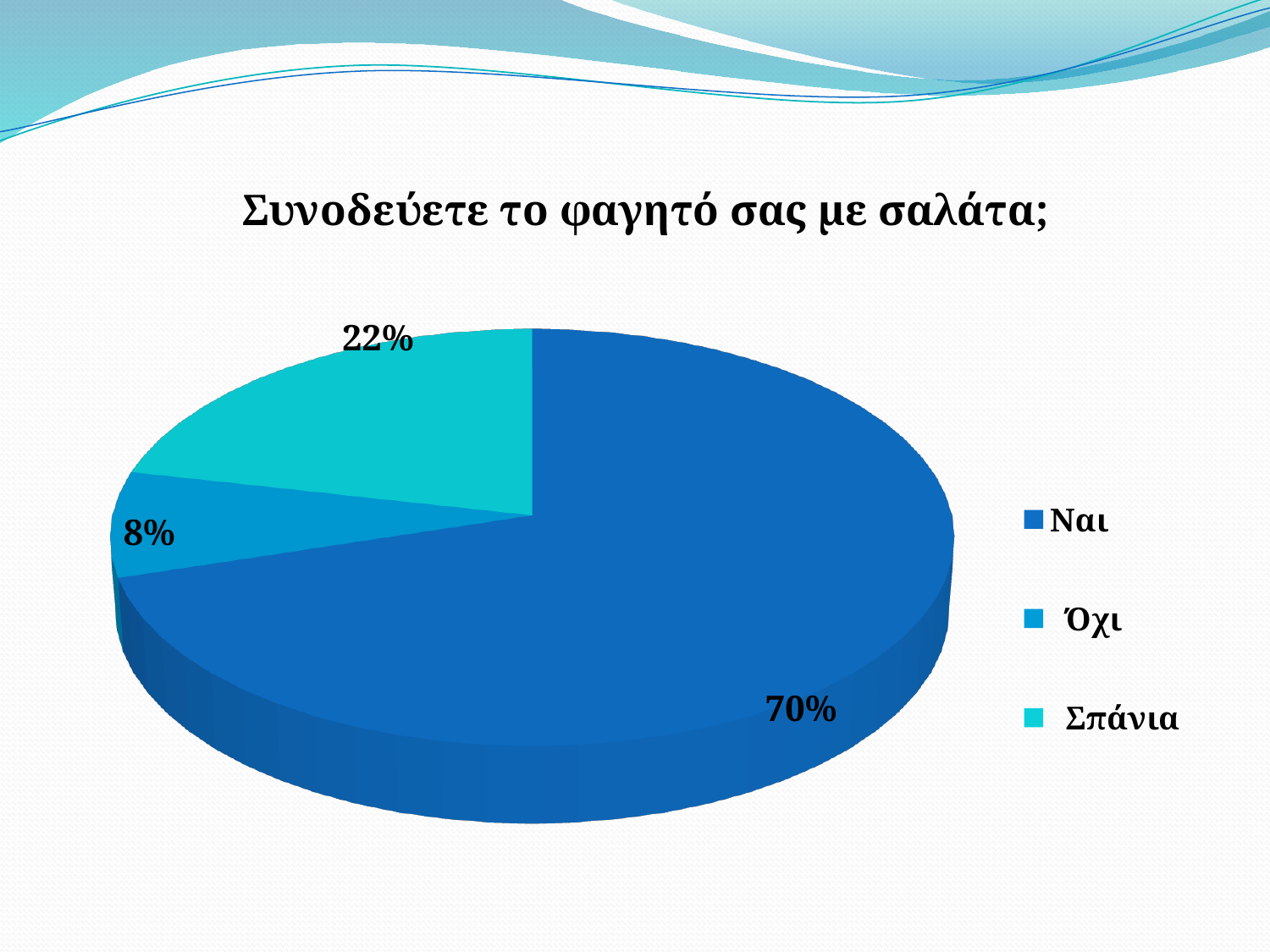
Which answer has the smallest share of the pie? Όχι What kind of chart is shown on the slide? Pie chart Which answer has the largest share of the pie? Ναι What percentage of respondents answered Όχι? 8% Which is larger, the share for Όχι or the share for Σπάνια? Σπάνια What is the title of the chart? Συνοδεύετε το φαγητό σας με σαλάτα; What is the difference in percentage points between Ναι and Σπάνια? 48 What is the difference in percentage points between Σπάνια and Όχι? 14 Which category is shown in the lightest (turquoise) colour in the legend? Σπάνια What percentage of respondents answered Ναι? 70% What percentage of respondents answered Σπάνια? 22% How many categories does the pie chart show? 3